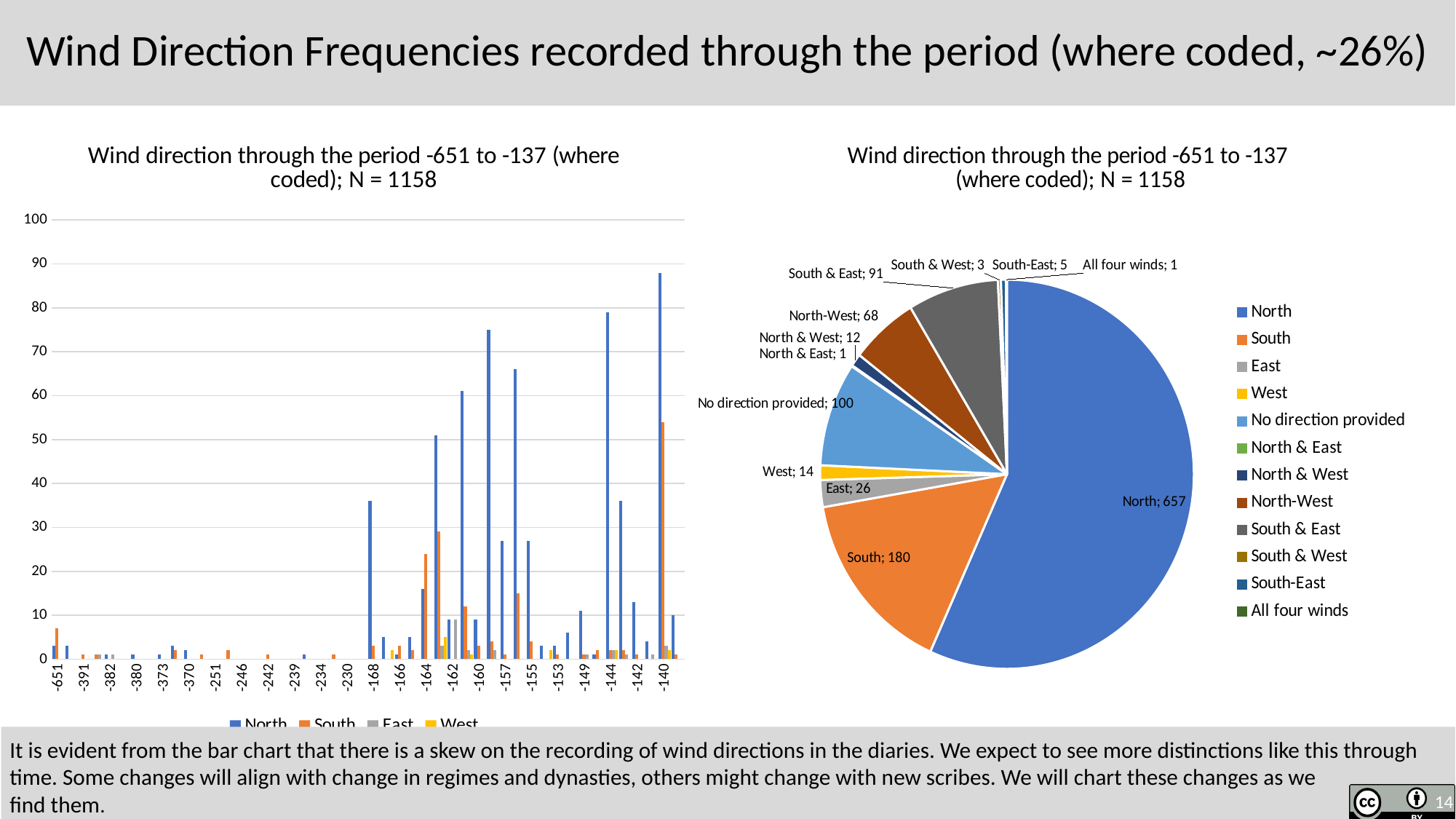
What kind of chart is the chart on the right of the slide? pie chart What kind of chart is the chart on the left of the slide? bar chart In the pie chart on the right, what is the difference between the values for South and East? 154 In the pie chart on the right, which category has the largest slice? North In the bar chart on the left, is the tallest North bar greater or less than 80? greater In the pie chart on the right, which is larger, North-West or North & West? North-West How many series does the legend of the bar chart on the left list? 4 What is the N value stated in the title of the pie chart on the right? N = 1158 In the pie chart on the right, what is the value for North? 657 How many entries does the legend of the pie chart on the right list? 12 In the pie chart on the right, what is the value for South & East? 91 In the pie chart on the right, what is the value for No direction provided? 100